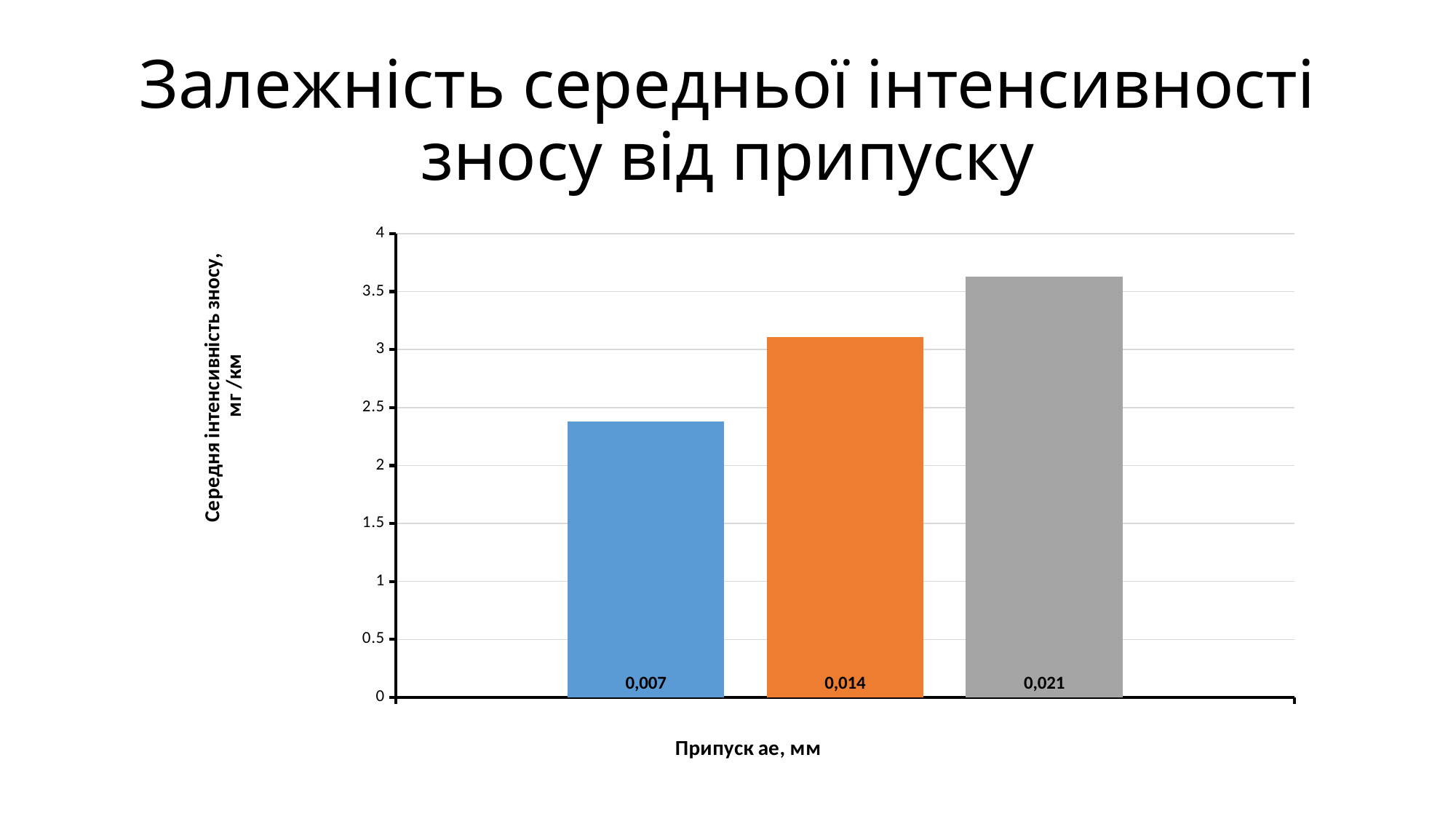
What is the title of the slide? Залежність середньої інтенсивності зносу від припуску Which category has the highest average wear intensity? 0,021 Which has a larger value, the bar for 0,014 or the bar for 0,007? 0,014 Is the value for 0,021 greater or less than 4? less Which category has the lowest average wear intensity? 0,007 Is the value for 0,021 greater or less than 3.5? greater Is the value for 0,007 greater or less than 2.5? less Do the values rise or fall as the allowance (припуск) increases along the x axis? rise How many bars are plotted in the chart? 3 What is the label of the x axis of the chart? Припуск ae, мм What kind of chart is shown on the slide? bar chart